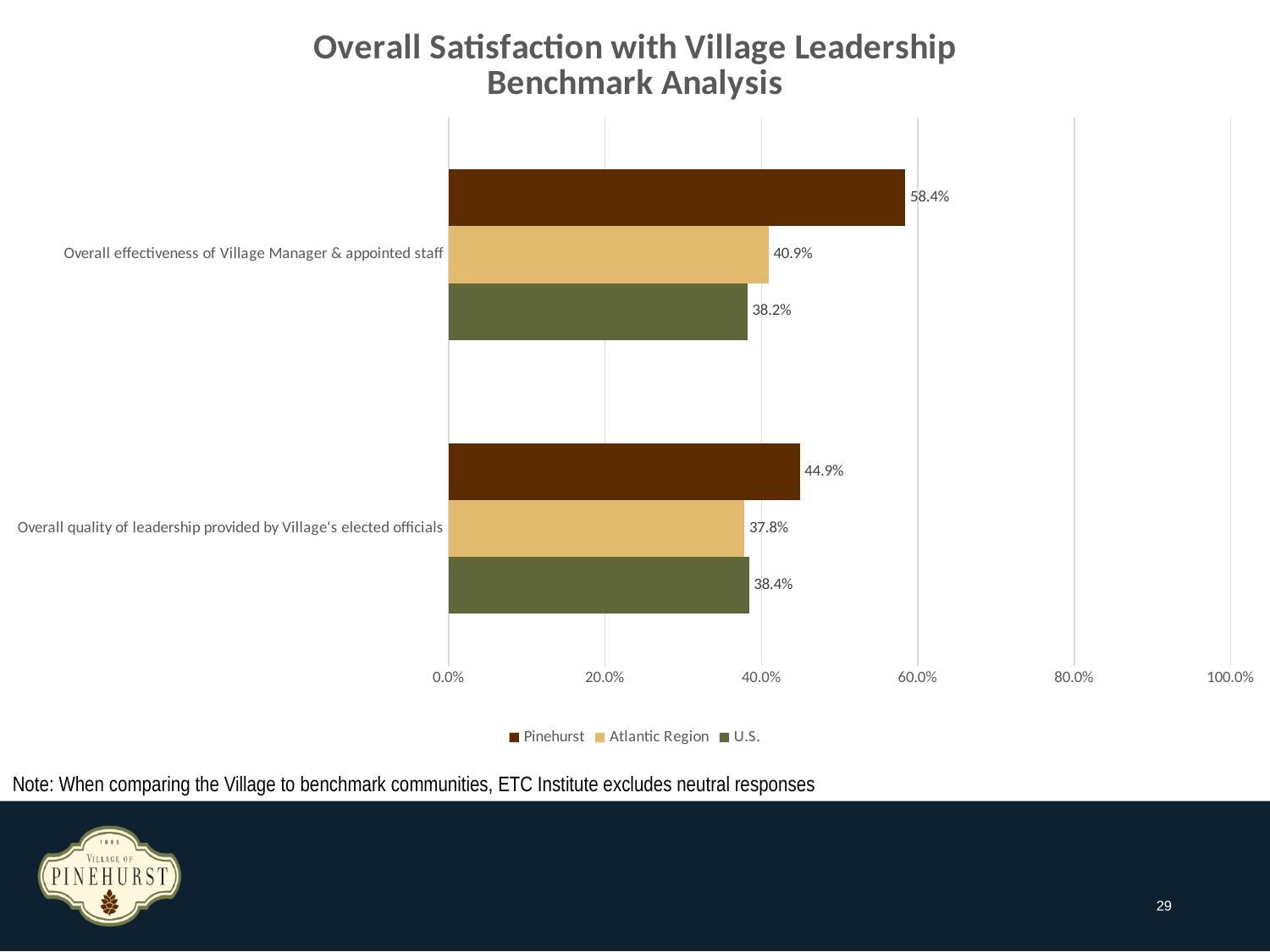
Which is larger for Overall quality of leadership provided by Village's elected officials: the Pinehurst value or the U.S. value? Pinehurst Which series has the highest value for Overall effectiveness of Village Manager & appointed staff? Pinehurst What is the U.S. value for Overall effectiveness of Village Manager & appointed staff? 38.2% What is the Pinehurst value for Overall quality of leadership provided by Village's elected officials? 44.9% What kind of chart is shown on the slide? Bar chart How many categories are shown on the chart? 2 What is the difference between the Pinehurst and U.S. values for Overall effectiveness of Village Manager & appointed staff? 20.2% How many series does the legend list? 3 What is the Atlantic Region value for Overall quality of leadership provided by Village's elected officials? 37.8% Which series has the lowest value for Overall quality of leadership provided by Village's elected officials? Atlantic Region What is the Pinehurst value for Overall effectiveness of Village Manager & appointed staff? 58.4% Is the Pinehurst value for Overall effectiveness of Village Manager & appointed staff greater or less than 60.0%? less